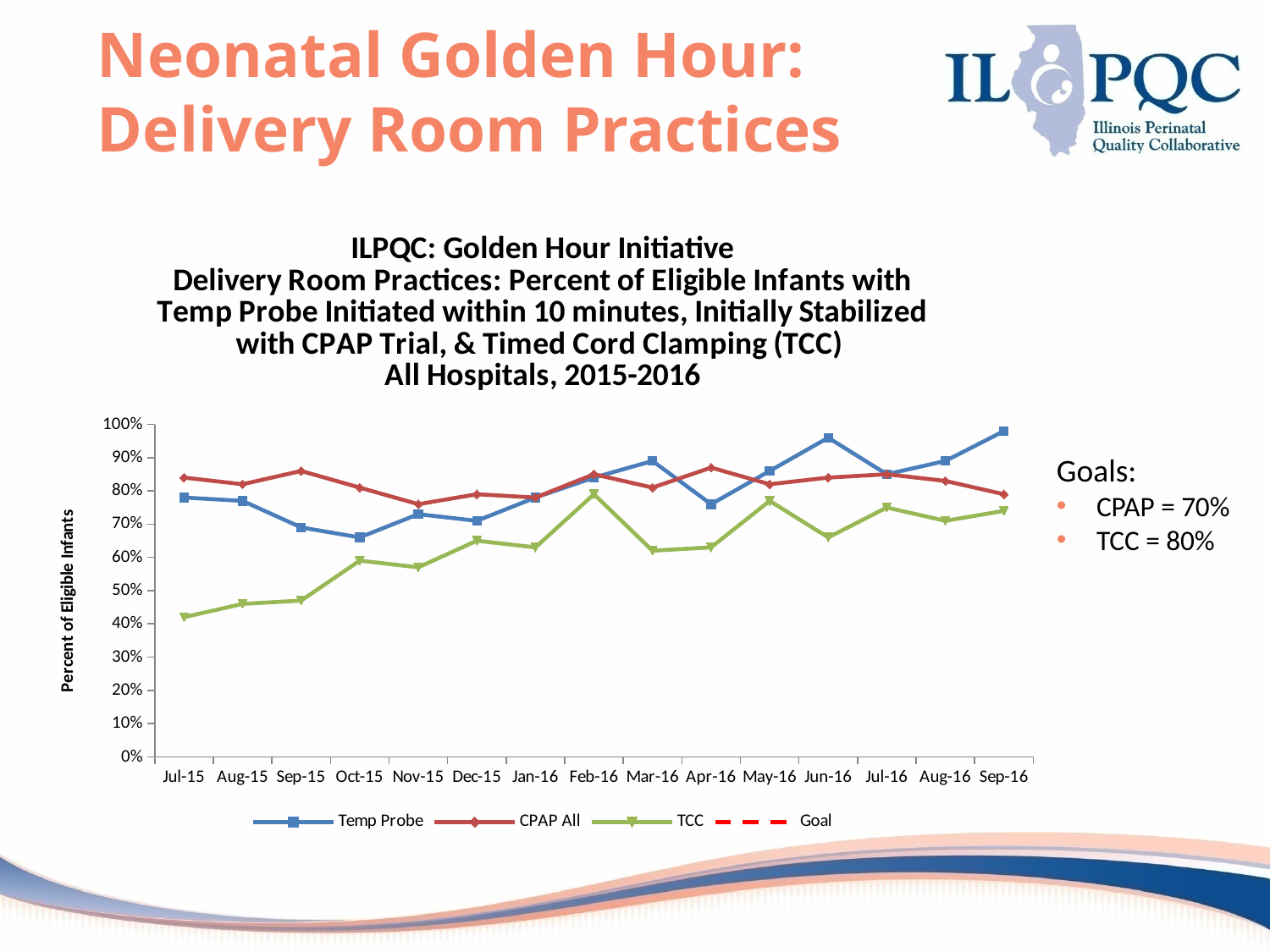
Is the value for TCC in Jul-15 greater or less than 50%? less Is the value for Temp Probe in Sep-16 greater or less than 90%? greater What kind of chart is shown on the slide? Line chart Is the value for TCC in Feb-16 greater or less than 70%? greater How many series does the chart legend list? 4 How many months are plotted along the x axis of the chart? 15 What is the title of the chart's y axis? Percent of Eligible Infants In which month is the TCC series at its lowest? Jul-15 Does the TCC series generally rise or fall from Jul-15 to Sep-16? Rise In Jul-15, which is larger: the Temp Probe value or the TCC value? Temp Probe In which month is the Temp Probe series at its lowest? Oct-15